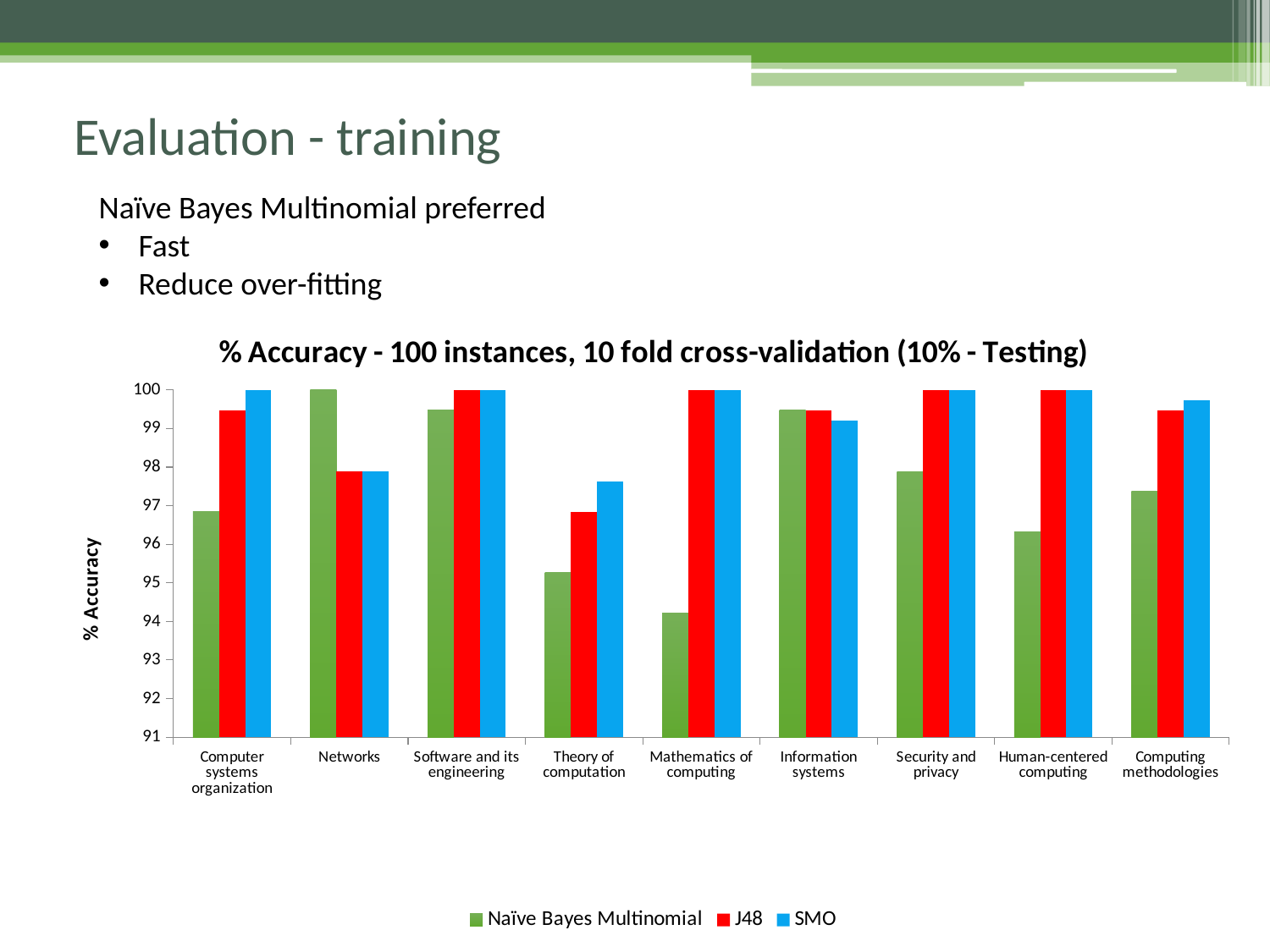
What is the % Accuracy for J48 in the Security and privacy category? 100 What kind of chart is shown on the slide? bar chart Is the % Accuracy for SMO in Theory of computation greater or less than 97? greater How many series does the chart's legend list? 3 Which category has the lowest % Accuracy for Naïve Bayes Multinomial? Mathematics of computing Is the % Accuracy for Naïve Bayes Multinomial in Theory of computation greater or less than 96? less What is the title of the chart? % Accuracy - 100 instances, 10 fold cross-validation (10% - Testing) In the Networks category, which series has the higher % Accuracy: Naïve Bayes Multinomial or J48? Naïve Bayes Multinomial Which category has the highest % Accuracy for Naïve Bayes Multinomial? Networks What is the % Accuracy for SMO in the Mathematics of computing category? 100 What is the % Accuracy for Naïve Bayes Multinomial in the Networks category? 100 How many categories are shown along the x axis of the chart? 9